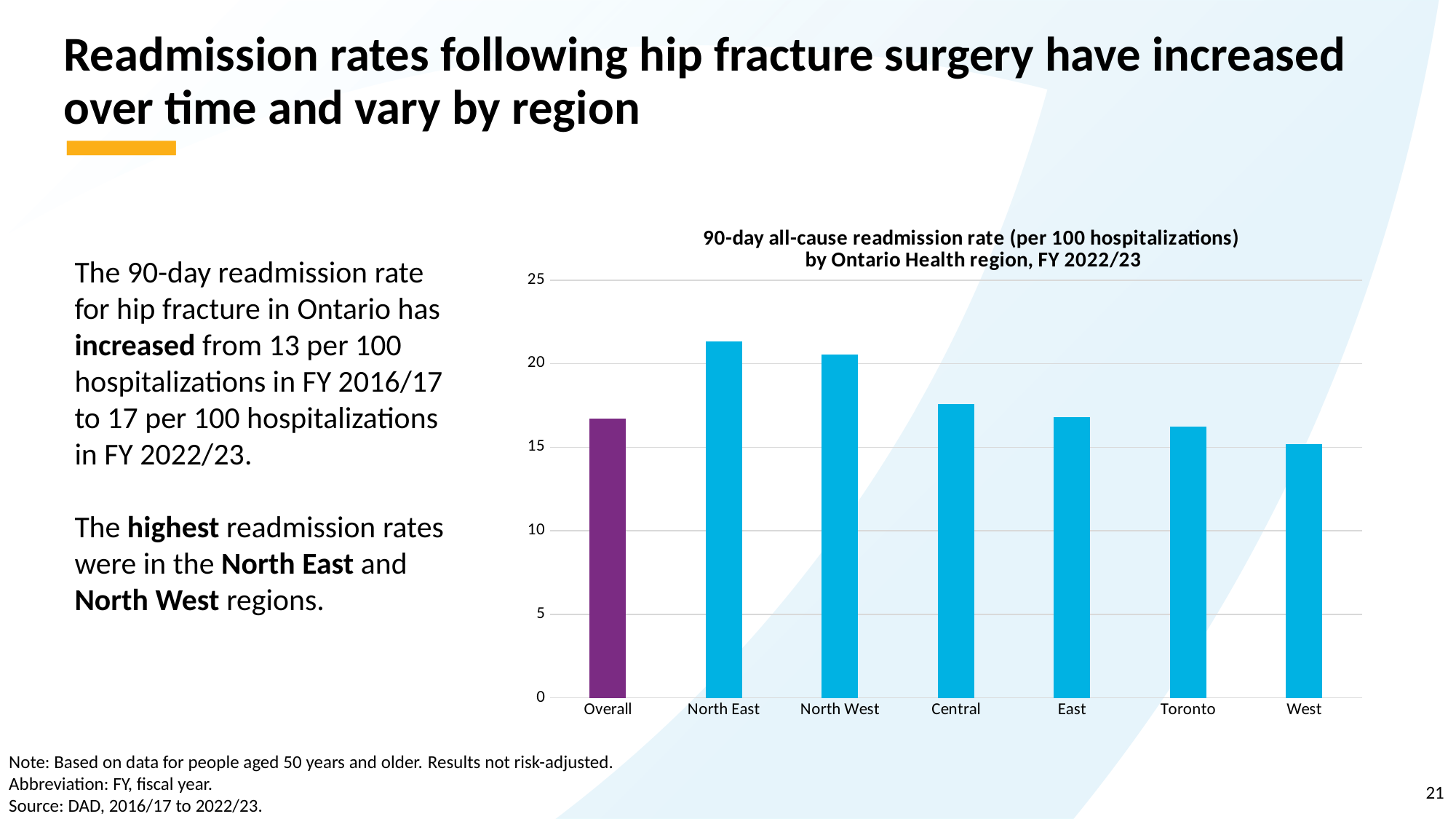
What colour is the Overall bar in the chart? purple Which has a higher readmission rate, Central or Toronto? Central Which region has the lowest 90-day readmission rate in the chart? West Is the value for North East greater or less than 20? greater Do the values rise or fall moving from North East to West along the x axis? fall Is the value for Central greater or less than 20? less Which region has the highest 90-day readmission rate in the chart? North East Is the value for Overall greater or less than 15? greater What kind of chart is shown on the slide? bar chart How many categories are shown on the x axis of the chart? 7 Which has a higher readmission rate, North East or West? North East